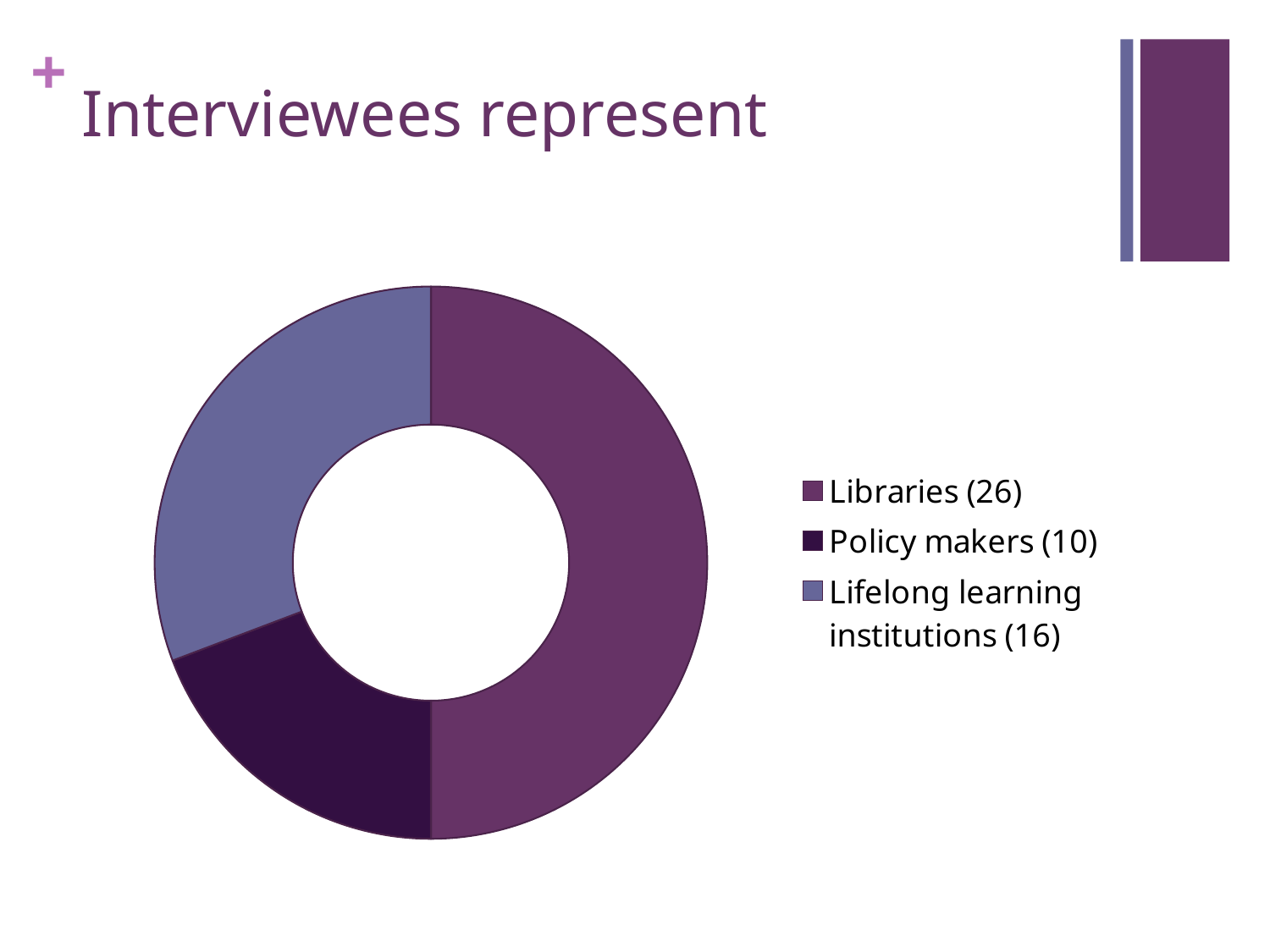
Which category has the largest number of interviewees? Libraries What kind of chart is shown on the slide? doughnut chart What share of the chart does the Libraries slice represent? 50% What is the difference between the number of Libraries interviewees and Policy makers interviewees? 16 How many interviewees are from Libraries? 26 How many categories does the chart show? 3 What is the difference between the number of Lifelong learning institutions interviewees and Policy makers interviewees? 6 What is the title of the slide containing the chart? Interviewees represent How many interviewees are Policy makers? 10 Which category has the smallest number of interviewees? Policy makers How many interviewees are from Lifelong learning institutions? 16 Which has more interviewees, Lifelong learning institutions or Policy makers? Lifelong learning institutions